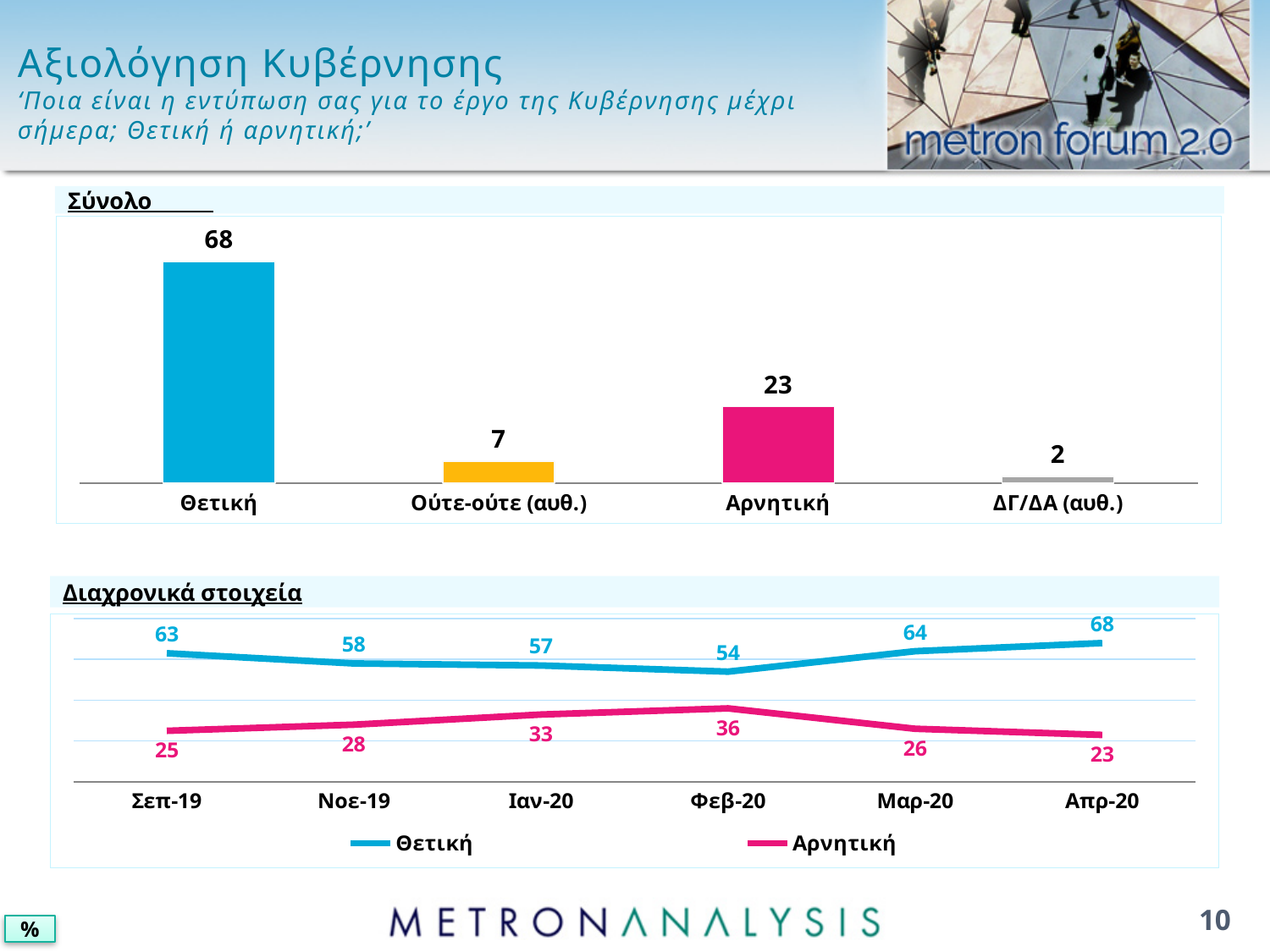
What kind of chart is the 'Σύνολο' chart? Bar chart In the 'Διαχρονικά στοιχεία' chart, does Θετική rise or fall from Φεβ-20 to Απρ-20? Rise In the 'Διαχρονικά στοιχεία' chart, what is the value of Αρνητική for Ιαν-20? 33 In the 'Σύνολο' chart, how many categories are shown? 4 In the 'Σύνολο' chart, what is the value for Θετική? 68 In the 'Σύνολο' chart, which category has the lowest value? ΔΓ/ΔΑ (αυθ.) In the 'Διαχρονικά στοιχεία' chart, how many series does the legend list? 2 In the 'Σύνολο' chart, what is the value for Αρνητική? 23 In the 'Διαχρονικά στοιχεία' chart, what is the value of Θετική for Φεβ-20? 54 In the 'Διαχρονικά στοιχεία' chart, which is larger for Σεπ-19: Θετική or Αρνητική? Θετική In the 'Σύνολο' chart, what is the difference between Θετική and Αρνητική? 45 In the 'Διαχρονικά στοιχεία' chart, in which month does Αρνητική reach its highest value? Φεβ-20